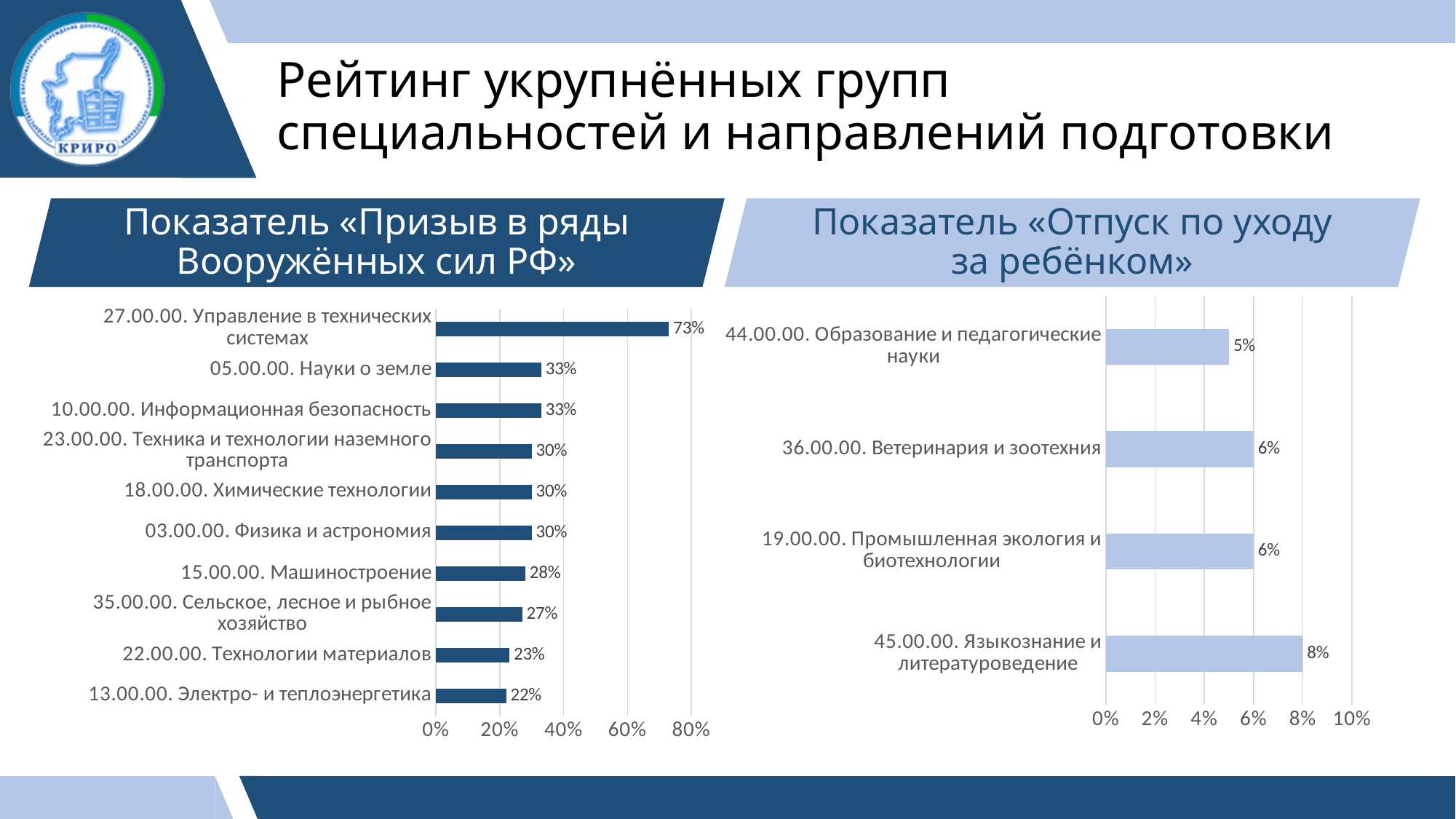
In the chart «Призыв в ряды Вооружённых сил РФ», what is the value for 15.00.00. Машиностроение? 28% In the chart «Отпуск по уходу за ребёнком», what is the value for 45.00.00. Языкознание и литературоведение? 8% In the chart «Отпуск по уходу за ребёнком», how many categories are shown? 4 In the chart «Призыв в ряды Вооружённых сил РФ», which category has the highest value? 27.00.00. Управление в технических системах In the chart «Призыв в ряды Вооружённых сил РФ», which is larger: 22.00.00. Технологии материалов or 35.00.00. Сельское, лесное и рыбное хозяйство? 35.00.00. Сельское, лесное и рыбное хозяйство In the chart «Призыв в ряды Вооружённых сил РФ», what is the difference between 27.00.00. Управление в технических системах and 05.00.00. Науки о земле? 40% In the chart «Отпуск по уходу за ребёнком», what is the difference between 45.00.00. Языкознание и литературоведение and 44.00.00. Образование и педагогические науки? 3% In the chart «Отпуск по уходу за ребёнком», which category has the lowest value? 44.00.00. Образование и педагогические науки In the chart «Призыв в ряды Вооружённых сил РФ», what is the value for 27.00.00. Управление в технических системах? 73% In the chart «Призыв в ряды Вооружённых сил РФ», which category has the lowest value? 13.00.00. Электро- и теплоэнергетика In the chart «Призыв в ряды Вооружённых сил РФ», how many categories are shown? 10 What type of chart is used in «Отпуск по уходу за ребёнком»? Bar chart